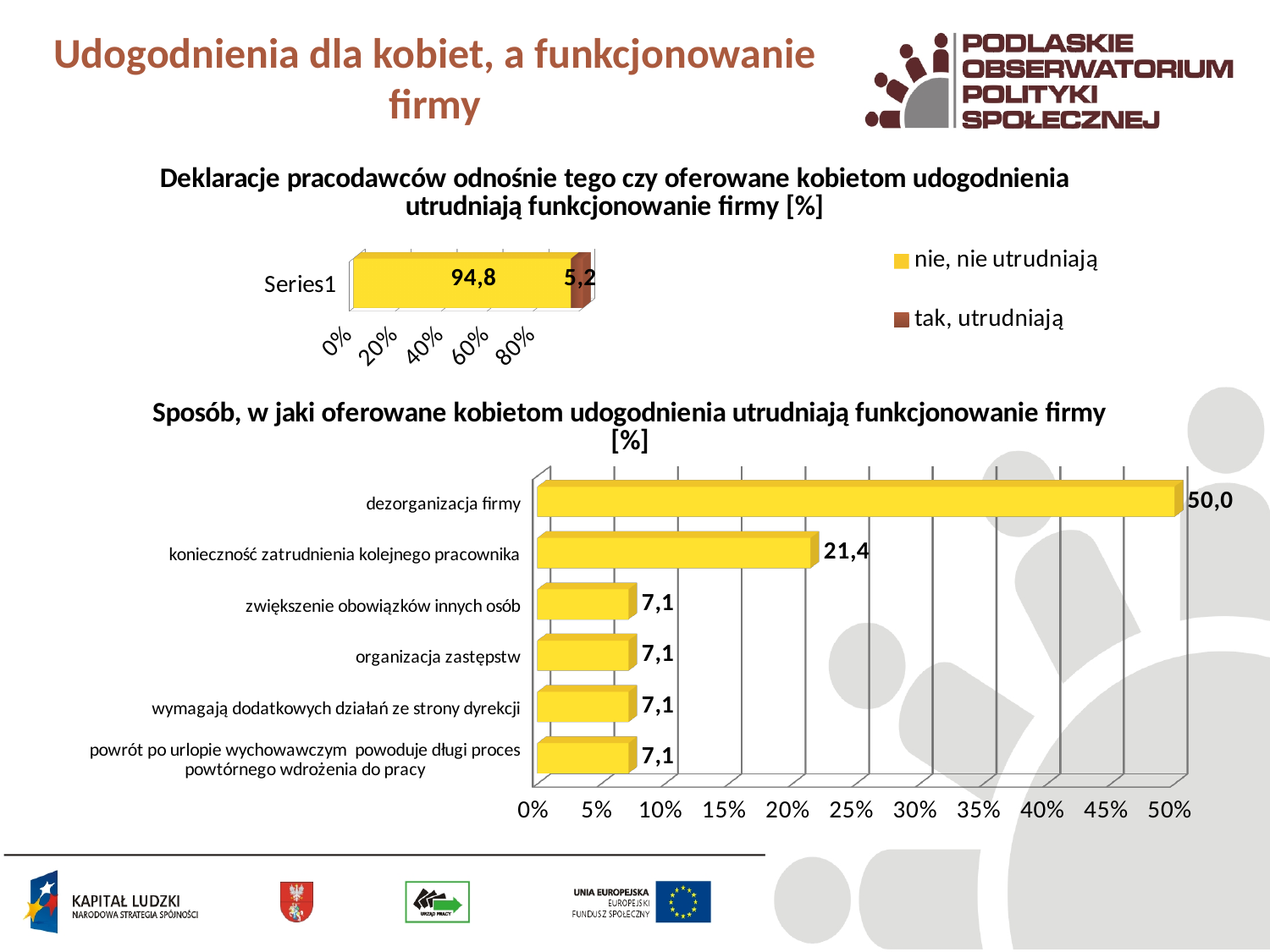
In the bottom chart (Sposób, w jaki...), what is the difference between "dezorganizacja firmy" and "konieczność zatrudnienia kolejnego pracownika"? 28,6 In the bottom chart (Sposób, w jaki...), what is the value for "konieczność zatrudnienia kolejnego pracownika"? 21,4 In the top chart (Deklaracje pracodawców...), what is the value for "tak, utrudniają"? 5,2 In the bottom chart (Sposób, w jaki...), which is larger: "konieczność zatrudnienia kolejnego pracownika" or "organizacja zastępstw"? konieczność zatrudnienia kolejnego pracownika In the bottom chart (Sposób, w jaki...), what is the value for "dezorganizacja firmy"? 50,0 In the bottom chart (Sposób, w jaki...), which category has the highest value? dezorganizacja firmy In the top chart (Deklaracje pracodawców...), what is the value for "nie, nie utrudniają"? 94,8 In the top chart (Deklaracje pracodawców...), how many series does the legend list? 2 In the bottom chart (Sposób, w jaki...), what is the value for "zwiększenie obowiązków innych osób"? 7,1 In the top chart (Deklaracje pracodawców...), what is the difference between the "nie, nie utrudniają" and "tak, utrudniają" values? 89,6 In the bottom chart (Sposób, w jaki...), how many categories are shown? 6 What kind of chart is the bottom chart (Sposób, w jaki...)? bar chart